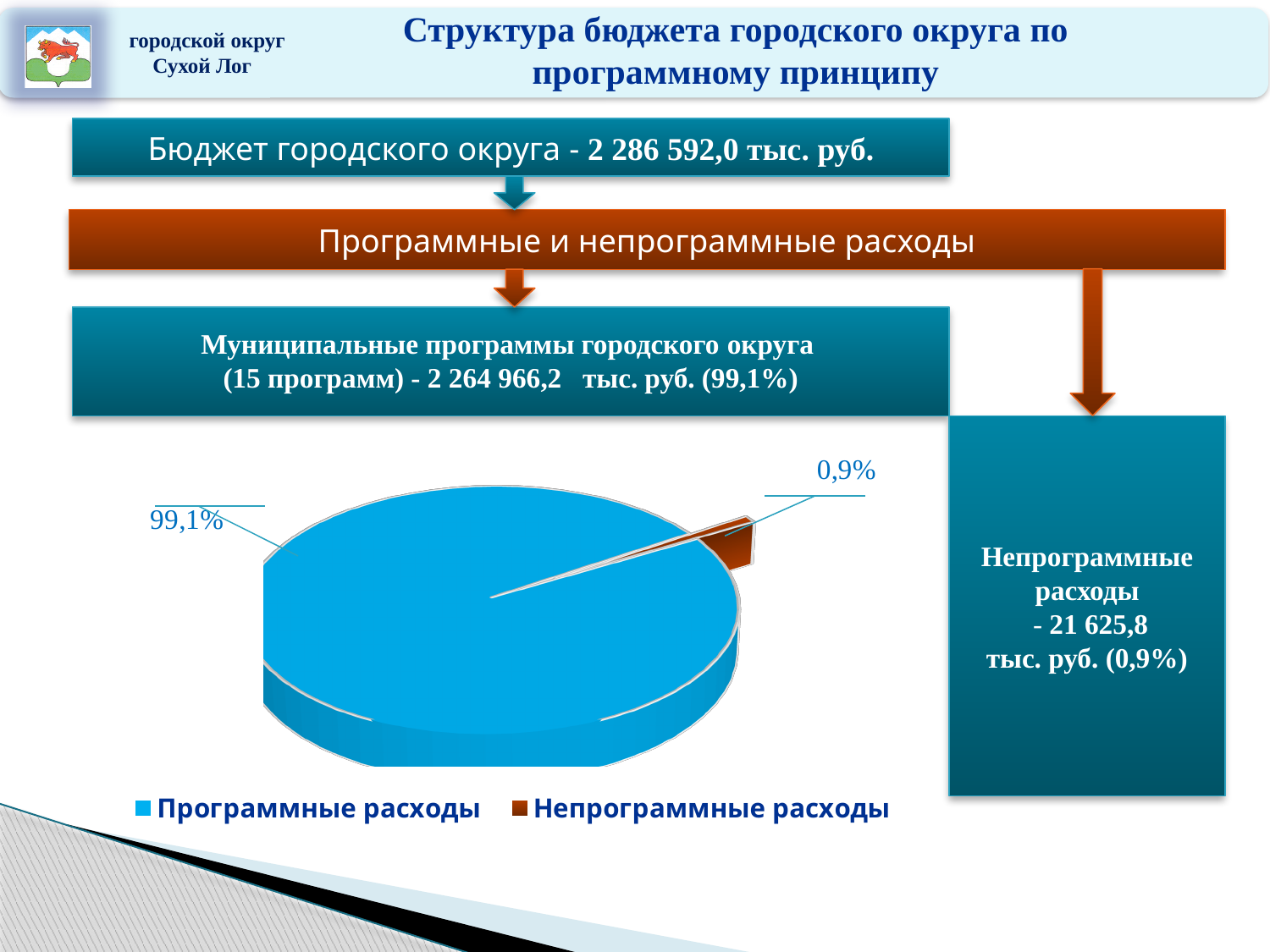
What kind of chart is shown on the slide? pie chart What share of the pie does Программные расходы have? 99,1% What is the difference in percentage points between Программные расходы and Непрограммные расходы? 98,2 Which slice of the pie is the smallest? Непрограммные расходы How many entries does the legend list? 2 What share of the pie does Непрограммные расходы have? 0,9% Which slice of the pie is the largest? Программные расходы Which is larger, the share for Программные расходы or for Непрограммные расходы? Программные расходы How many slices does the pie chart have? 2 What colour is the Непрограммные расходы slice in the pie chart? brown What colour is the Программные расходы slice in the pie chart? blue